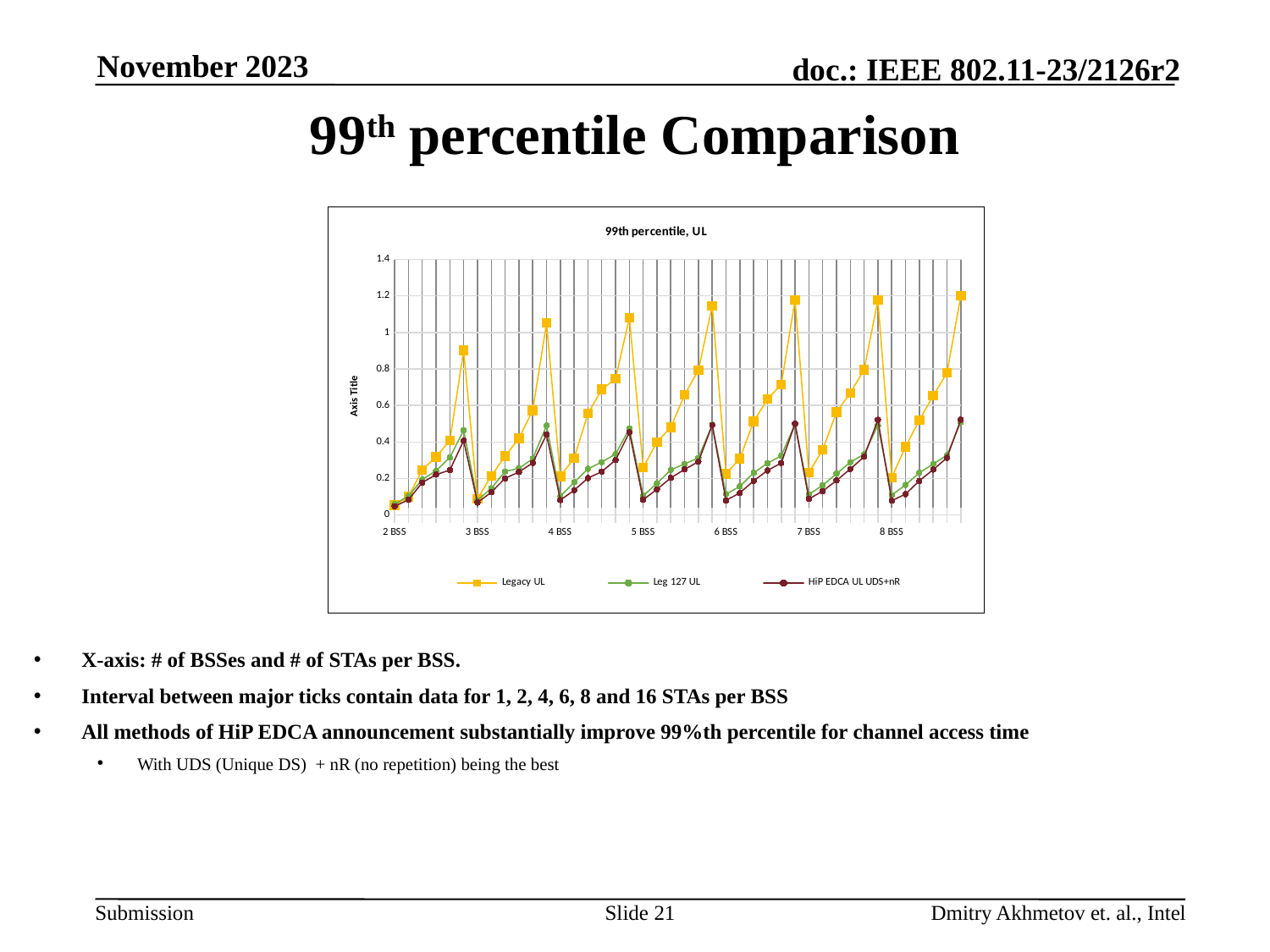
Is the highest Legacy UL value in the 3 BSS group greater or less than 0.8? greater How many BSS categories are labelled on the x axis? 7 Is the highest Legacy UL value in the 8 BSS group greater or less than 1? greater What is the title of the chart? 99th percentile, UL At the peak of the 6 BSS group, which is larger: Legacy UL or Leg 127 UL? Legacy UL Which series has the lowest values on the chart? HiP EDCA UL UDS+nR Is the highest HiP EDCA UL UDS+nR value in the 8 BSS group greater or less than 0.6? less Which series reaches the highest values on the chart? Legacy UL How many series does the legend list? 3 Which series are listed in the legend? Legacy UL, Leg 127 UL, HiP EDCA UL UDS+nR Within each BSS group, do the Legacy UL values rise or fall from left to right? rise What kind of chart is shown on the slide? line chart